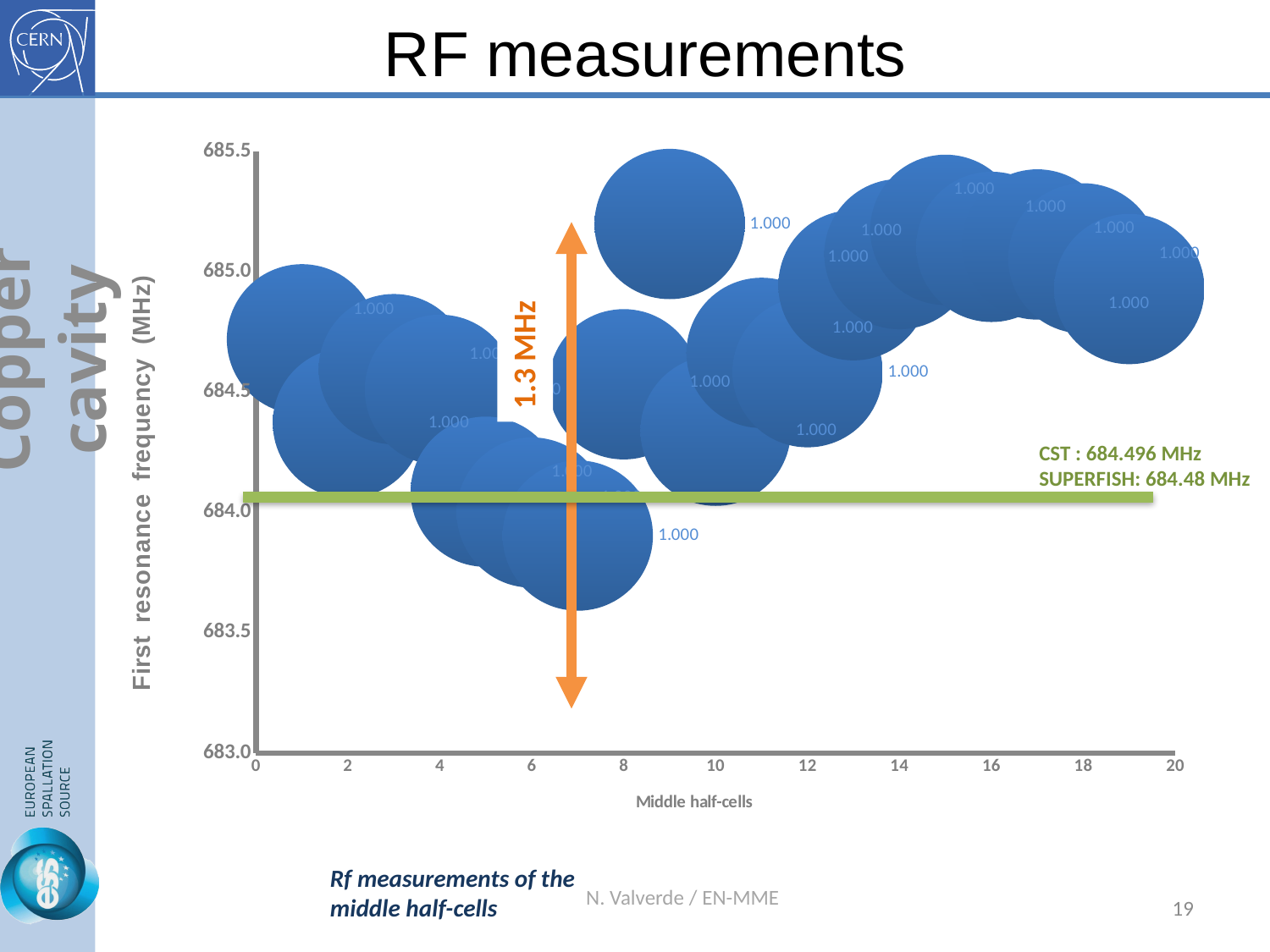
What value is written on the orange vertical arrow in the chart? 1.3 MHz Are the bubbles at the right end of the x axis (half-cells 14-19) generally higher or lower in frequency than those at the left end (half-cells 1-5)? higher Is the first resonance frequency of the leftmost bubble (near middle half-cell 1) greater or less than 684.5 MHz? greater What kind of chart is shown on the slide? bubble chart Is the first resonance frequency of the rightmost bubble (near middle half-cell 19) greater or less than 684.5 MHz? greater What frequency value is given for CST in the annotation on the chart? 684.496 MHz Is the first resonance frequency of the lowest bubble (near middle half-cell 7-8) greater or less than 684.5 MHz? less